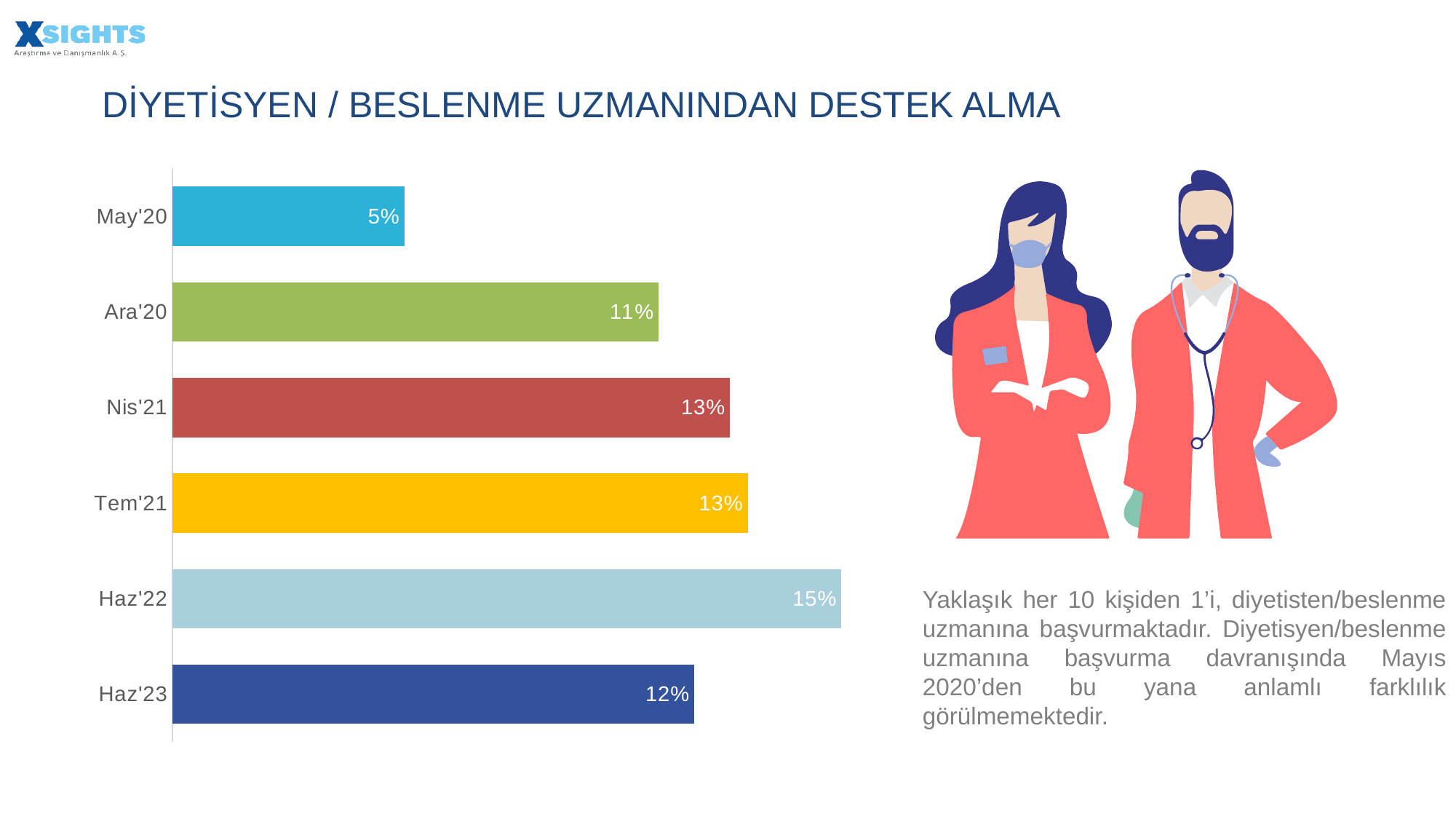
What is the difference between the values for Haz'22 and Haz'23? 3% What is the value for Haz'23? 12% What is the difference between the values for Haz'22 and May'20? 10% What is the value for May'20? 5% How many periods are shown in the chart? 6 What is the value for Haz'22? 15% Which is larger, the value for Ara'20 or the value for Nis'21? Nis'21 Which period has the highest value? Haz'22 What is the value for Ara'20? 11% What kind of chart is shown on the slide? Bar chart Which period has the lowest value? May'20 What is the title of the slide? DİYETİSYEN / BESLENME UZMANINDAN DESTEK ALMA